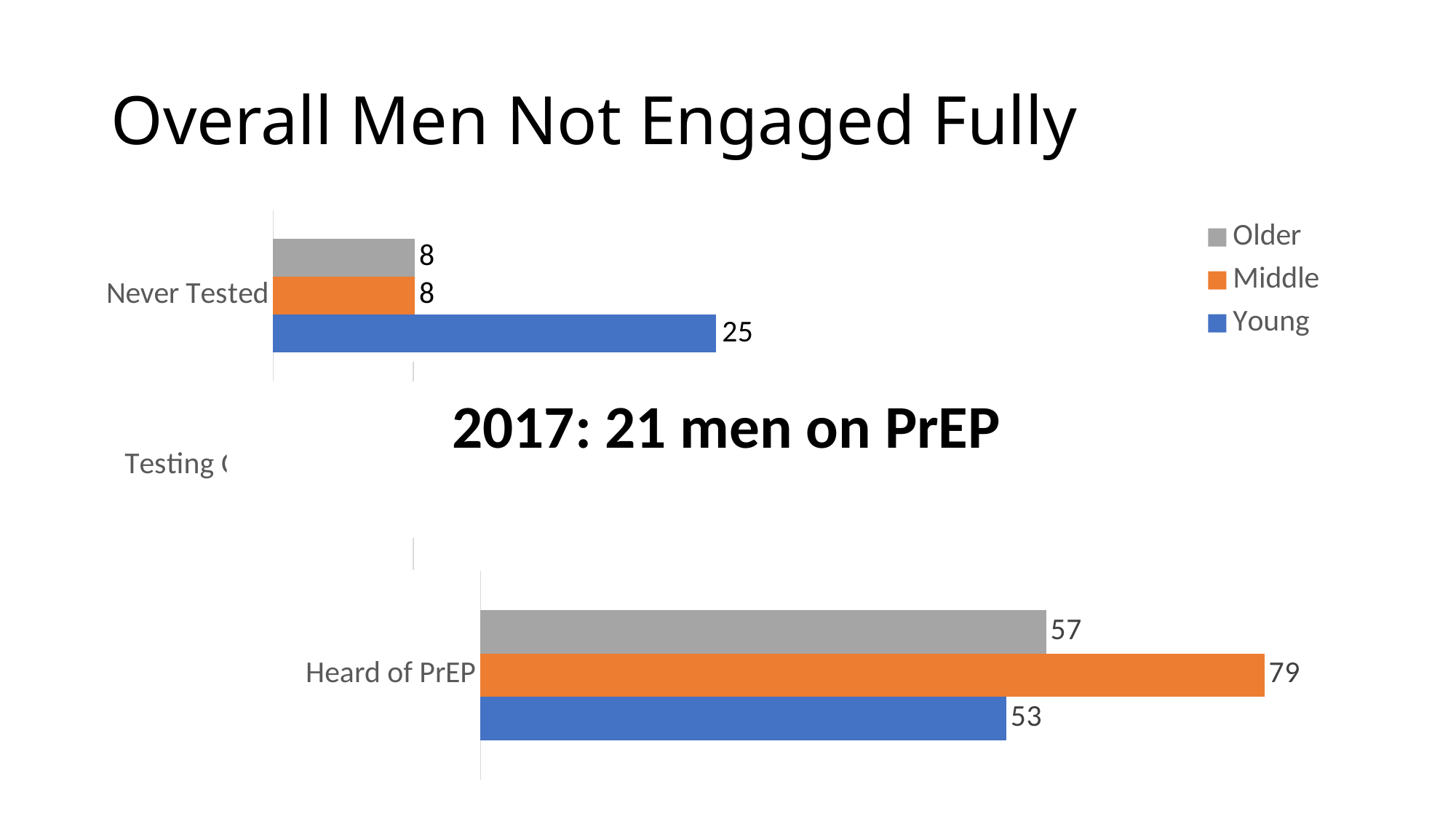
How many series does the legend list? 3 What is the value for Older in the Heard of PrEP category? 57 What is the difference between the Young and Older values in the Never Tested category? 17 Which age group has the highest value in the Heard of PrEP category? Middle What is the value for Young in the Never Tested category? 25 In the Heard of PrEP category, which is larger, the Older value or the Young value? Older What is the value for Young in the Heard of PrEP category? 53 Which age group has the lowest value in the Heard of PrEP category? Young What is the value for Middle in the Heard of PrEP category? 79 What is the value for Older in the Never Tested category? 8 Which age group has the highest value in the Never Tested category? Young What is the difference between the Middle and Young values in the Heard of PrEP category? 26